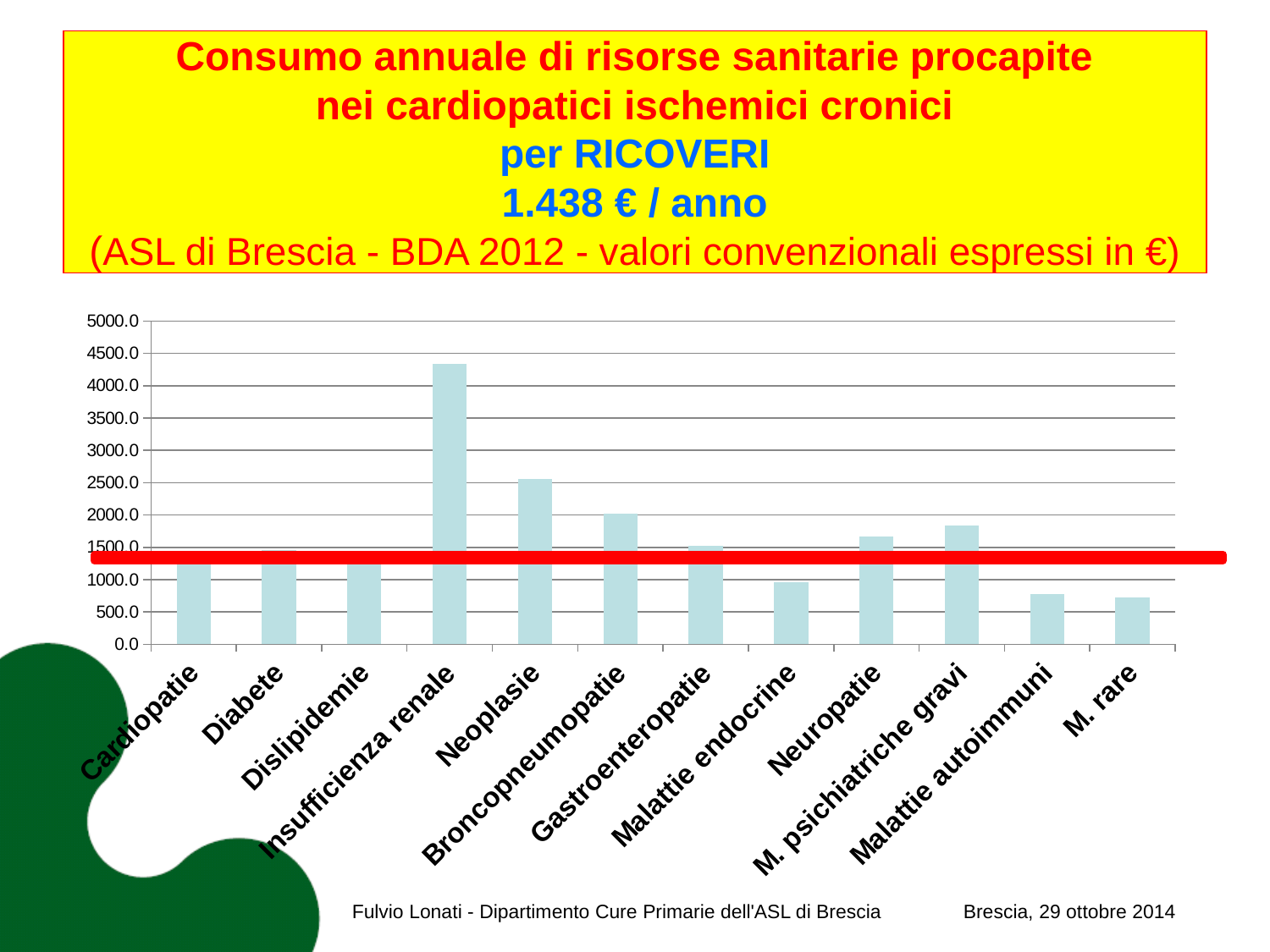
Is the value for M. rare greater or less than 1000.0? less Which category has the highest value in the chart? Insufficienza renale Which is larger, the value for Insufficienza renale or the value for Neuropatie? Insufficienza renale What annual per-capita value for hospital admissions (RICOVERI) is stated in the slide title? 1.438 € / anno Is the value for Neoplasie greater or less than 2000.0? greater Is the value for Insufficienza renale greater or less than 4000.0? greater What kind of chart is shown on the slide? bar chart How many categories are shown on the x axis of the chart? 12 Which is larger, the value for Neoplasie or the value for Broncopneumopatie? Neoplasie